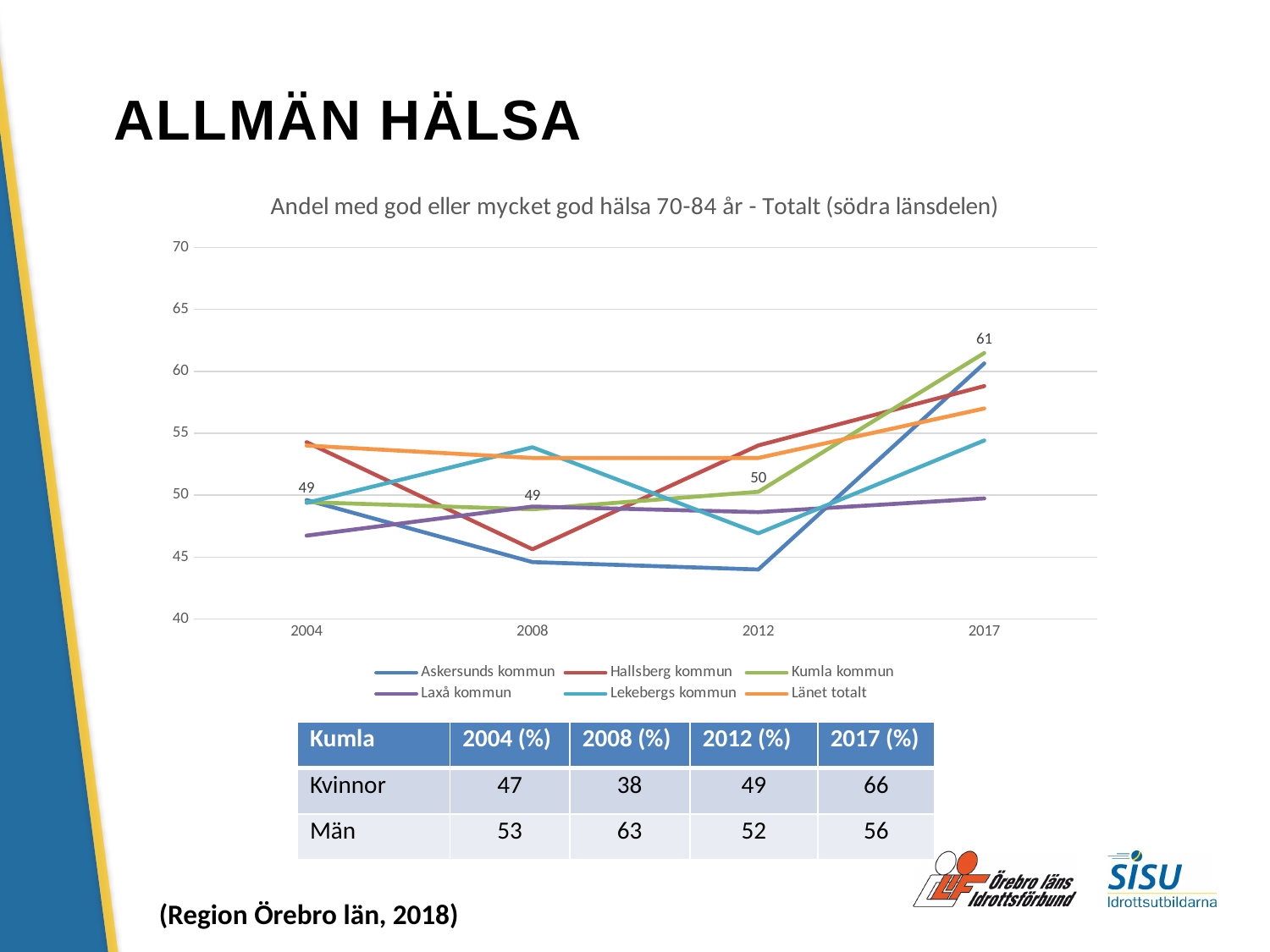
What kind of chart is shown on the slide? line chart Is the value for Hallsberg kommun in 2008 greater or less than 50? less What is the value for Kumla kommun in 2017? 61 How many series does the legend list? 6 By how much did the value for Kumla kommun increase from 2012 to 2017? 11 What is the value for Kumla kommun in 2012? 50 Does the value for Kumla kommun rise or fall between 2012 and 2017? rise Which is larger for Kumla kommun: the value in 2004 or the value in 2017? 2017 What is the value for Kumla kommun in 2004? 49 How many years are shown on the x axis? 4 What is the title of the chart? Andel med god eller mycket god hälsa 70-84 år - Totalt (södra länsdelen) Which series has the lowest value in 2017? Laxå kommun